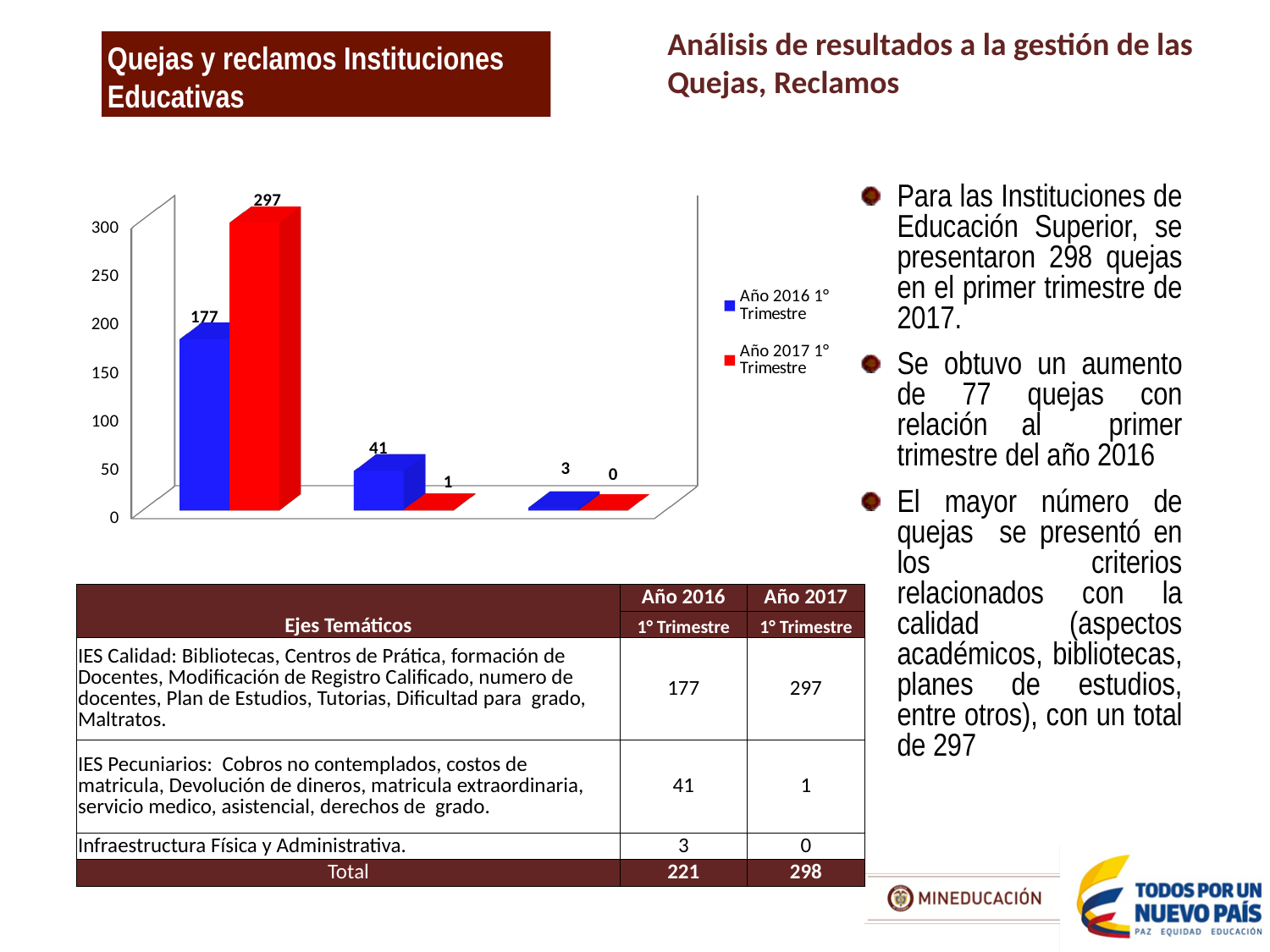
What is the value of the Año 2017 1° Trimestre bar in the first (leftmost) category group? 297 What is the value of the Año 2016 1° Trimestre bar in the first (leftmost) category group? 177 Which bar has the highest value in the chart? Año 2017 1° Trimestre in the first category group (297) What is the difference between the Año 2017 1° Trimestre and Año 2016 1° Trimestre values in the first category group? 120 How many series does the chart legend list? 2 In the second category group, which series has the larger value, Año 2016 1° Trimestre or Año 2017 1° Trimestre? Año 2016 1° Trimestre What is the value of the Año 2016 1° Trimestre bar in the second category group? 41 How many category groups of bars are plotted in the chart? 3 Is the Año 2016 1° Trimestre value in the first category group greater or less than 150? greater Which colour represents the Año 2017 1° Trimestre series in the chart? red What type of chart is shown on the slide? bar chart What is the value of the Año 2017 1° Trimestre bar in the third (rightmost) category group? 0